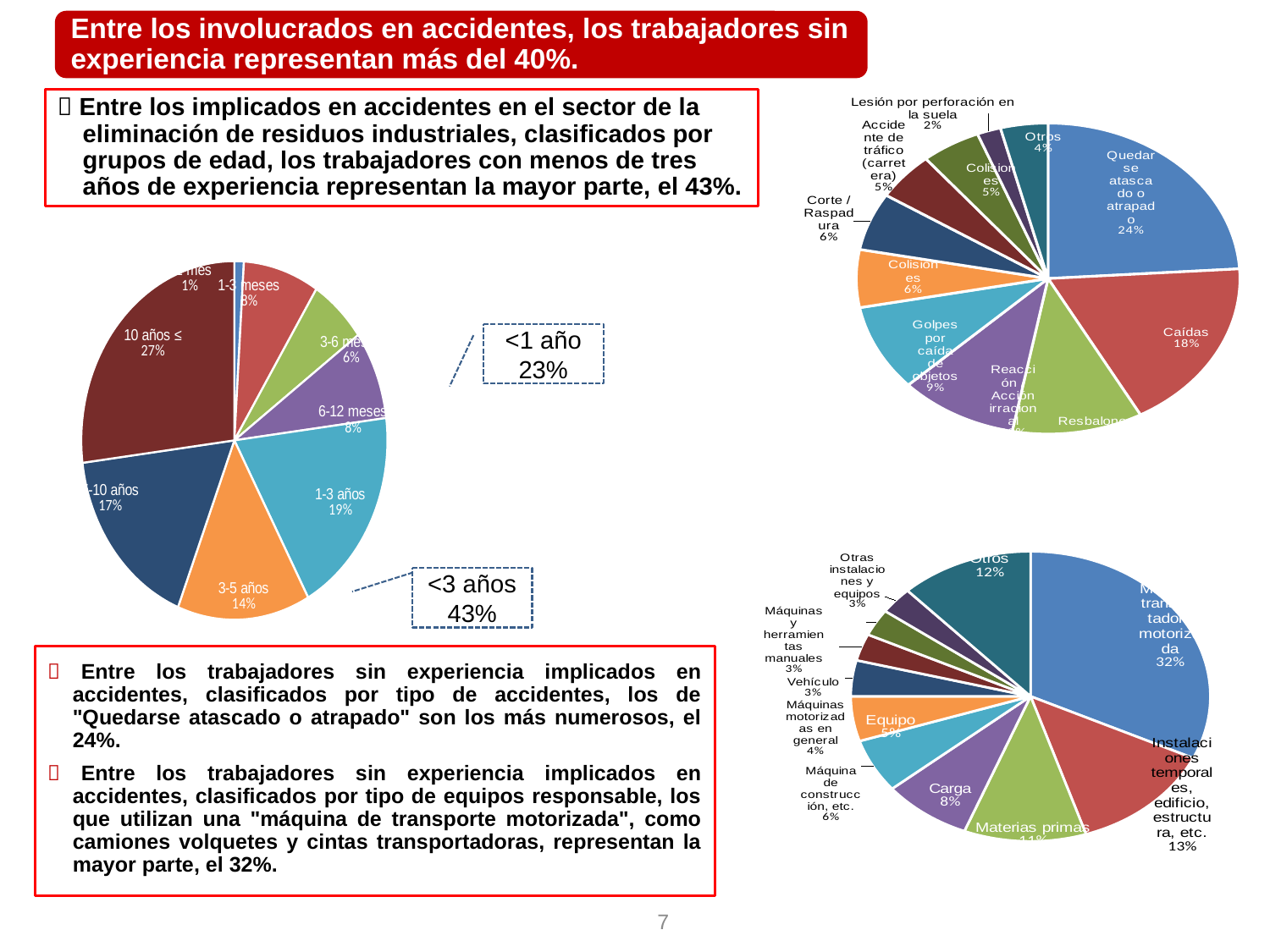
In the pie chart at the top right of the slide (accident types), what share is shown for 'Quedarse atascado o atrapado'? 24% In the pie chart at the bottom right of the slide (equipment types), what share is shown for 'Carga'? 8% In the pie chart on the left of the slide, what combined share does the callout give for workers with less than 3 years ('<3 años')? 43% In the pie chart on the left of the slide (experience groups), what share is shown for '3-5 años'? 14% In the pie chart at the top right of the slide (accident types), what share is shown for 'Caídas'? 18% In the pie chart at the bottom right of the slide (equipment types), what share is shown for 'Máquina transportadora motorizada'? 32% In the pie chart on the left of the slide (experience groups), what is the difference between the shares for '1-3 años' and '3-5 años'? 5% What type of chart is used for the three charts on this slide? Pie chart In the pie chart on the left of the slide (experience groups), what share is shown for '1-3 años'? 19% In the pie chart at the top right of the slide (accident types), which is larger: 'Golpes por caída de objetos' or 'Corte / Raspadura'? Golpes por caída de objetos In the pie chart at the top right of the slide (accident types), which category has the smallest share? Lesión por perforación en la suela In the pie chart on the left of the slide (experience groups), which category has the largest share? 10 años ≤